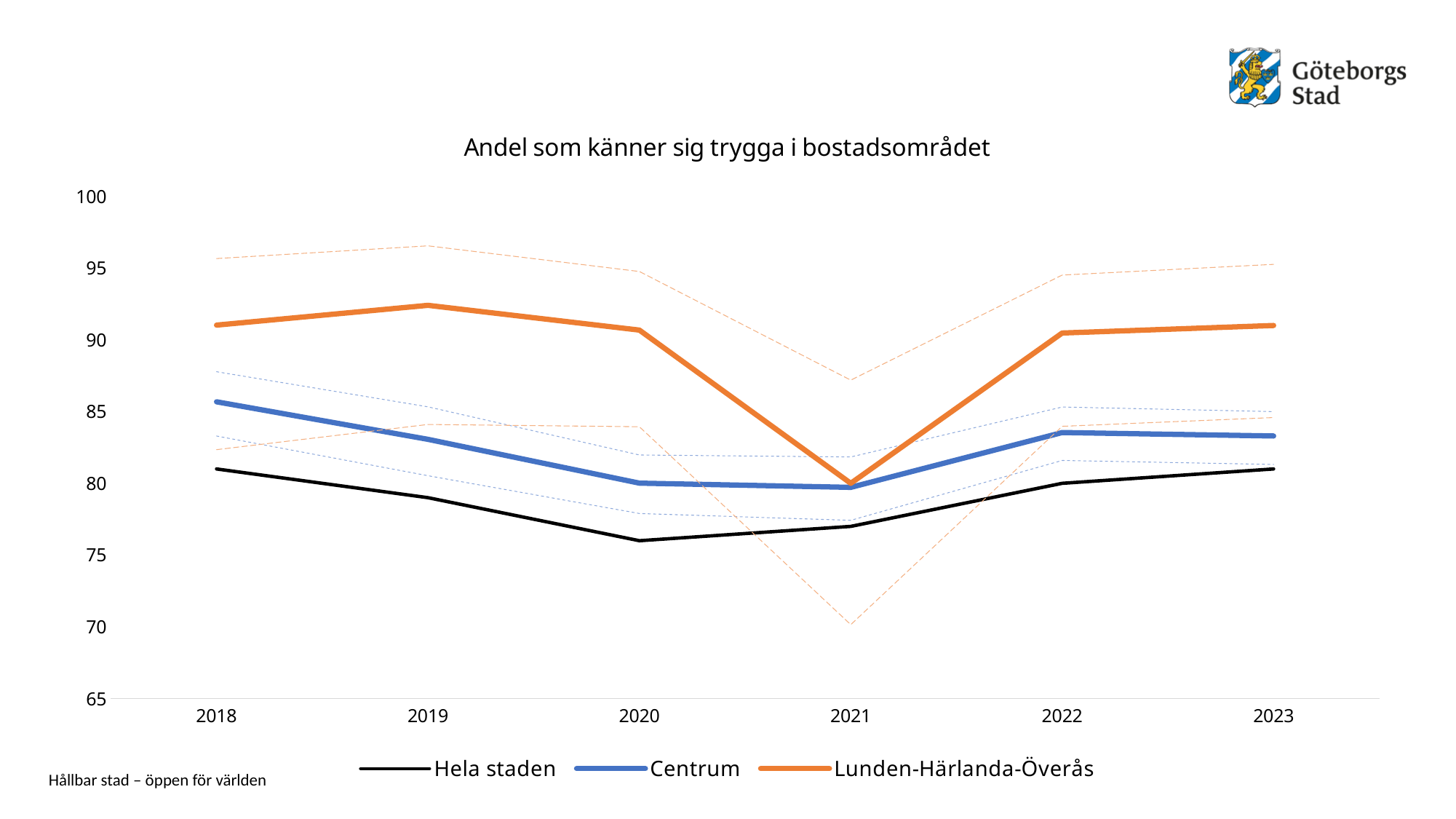
How many series does the legend list? 3 Is the value for Hela staden in 2020 greater or less than 80? less How many years are shown on the x axis? 6 In which year does Lunden-Härlanda-Överås reach its lowest value? 2021 What is the title of the chart? Andel som känner sig trygga i bostadsområdet Does the Hela staden line rise or fall from 2018 to 2020? fall In which year does Hela staden reach its lowest value? 2020 Which series is shown in orange in the legend? Lunden-Härlanda-Överås Which is higher in 2021, Centrum or Hela staden? Centrum What kind of chart is shown on the slide? line chart In which year does Lunden-Härlanda-Överås reach its highest value? 2019 Is the value for Lunden-Härlanda-Överås in 2019 greater or less than 90? greater